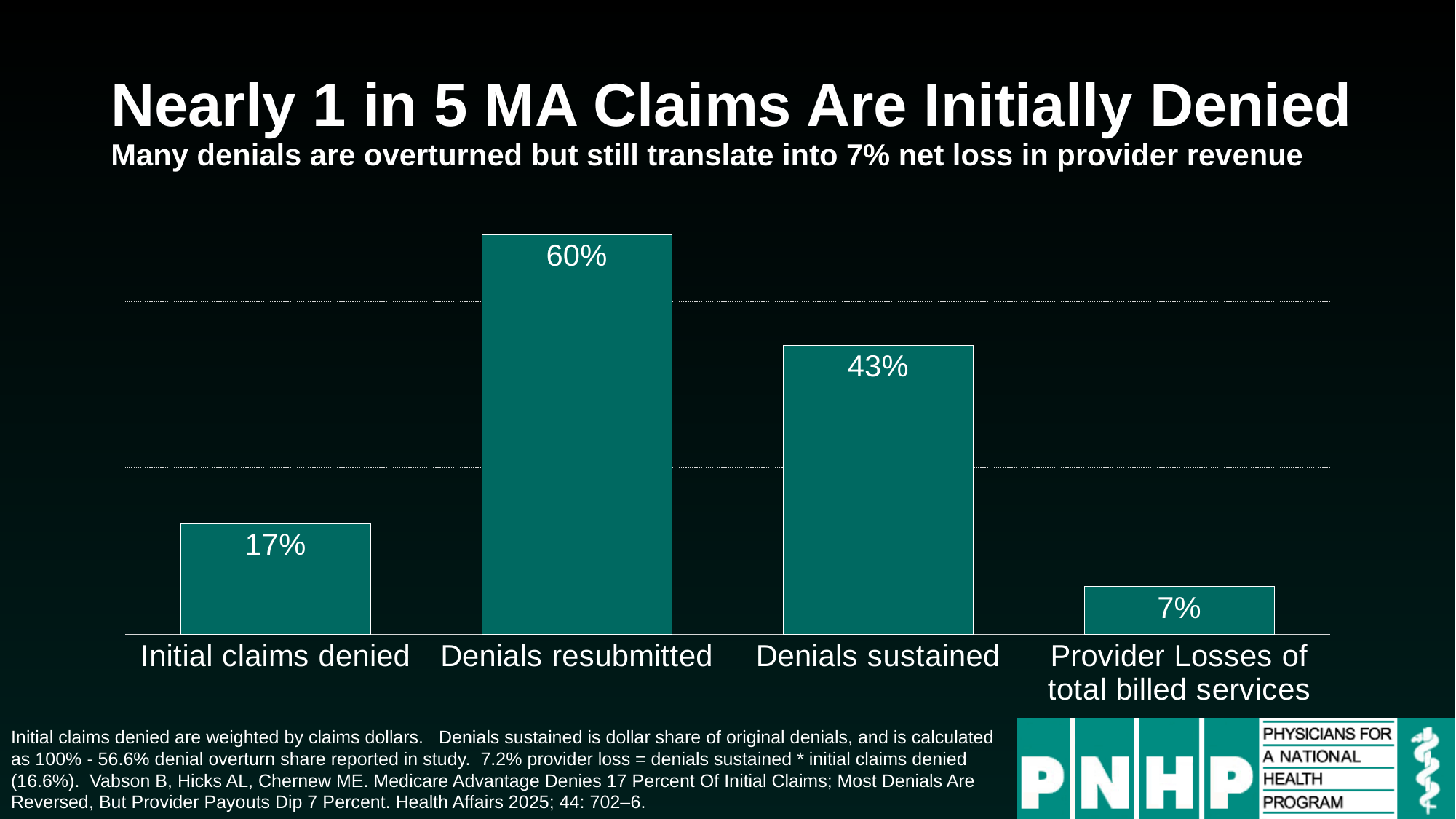
What is the difference between Initial claims denied and Provider Losses of total billed services? 10% Which category has the lowest value? Provider Losses of total billed services What kind of chart is shown on the slide? Bar chart What is the value for Initial claims denied? 17% What is the difference between Denials resubmitted and Denials sustained? 17% Which is larger, Initial claims denied or Denials sustained? Denials sustained Which category has the highest value? Denials resubmitted How many categories are shown in the chart? 4 What is the title of the slide? Nearly 1 in 5 MA Claims Are Initially Denied What is the value for Denials resubmitted? 60% What is the value for Denials sustained? 43% What is the value for Provider Losses of total billed services? 7%